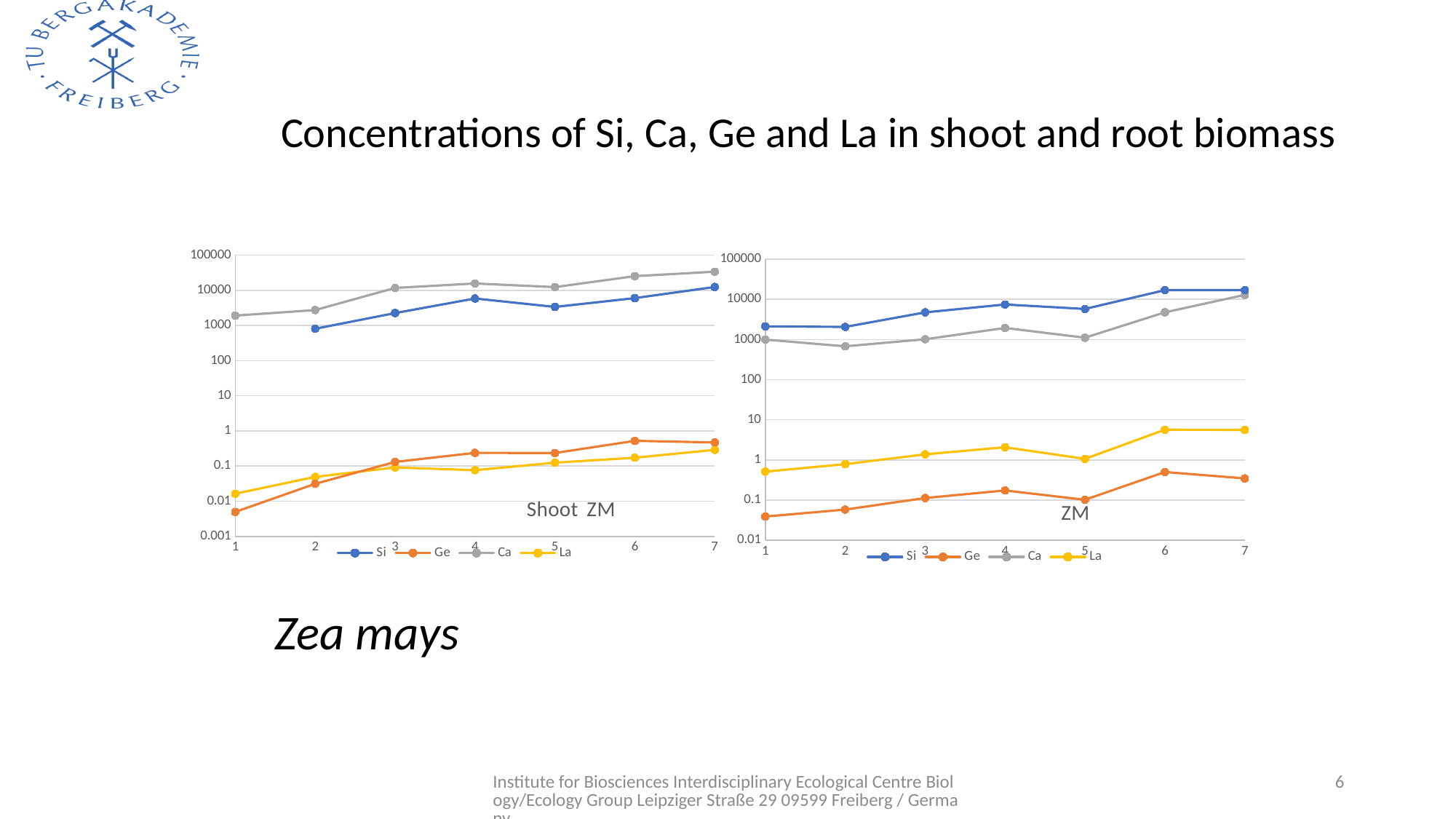
In the right chart ("ZM"), which is larger at point 1, Si or Ca? Si In the left chart ("Shoot ZM"), is the value of Ca at point 7 greater or less than 10000? greater In the left chart ("Shoot ZM"), which series has the highest values across the points? Ca In the right chart ("ZM"), does the Si series generally rise or fall from point 1 to point 7? rise What is the title of the slide? Concentrations of Si, Ca, Ge and La in shoot and root biomass What kind of chart is the left chart titled "Shoot ZM"? line chart In the right chart ("ZM"), is the value of Ca at point 2 greater or less than 1000? less In the right chart ("ZM"), is the value of Si at point 1 greater or less than 1000? greater How many series does the legend of the right chart ("ZM") list? 4 In the left chart ("Shoot ZM"), how many x-axis points are shown? 7